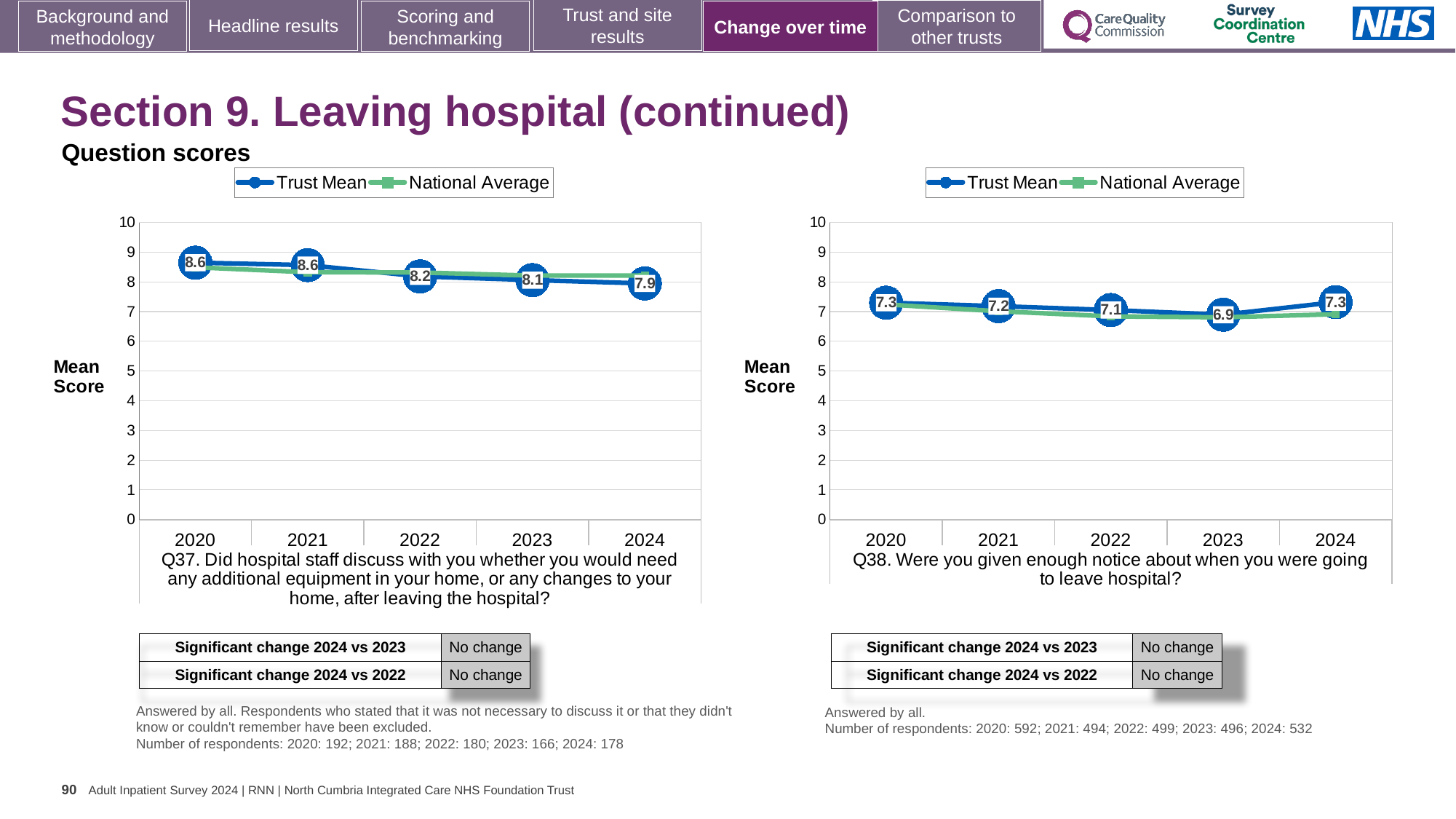
On the Q37 chart (left), what is the difference between the Trust Mean score in 2020 and in 2024? 0.7 How many series does the legend of the Q37 chart (left) list? 2 On the Q38 chart (right), what is the difference between the Trust Mean score in 2024 and in 2023? 0.4 On the Q37 chart (left), does the Trust Mean score rise or fall from 2020 to 2024? fall On the Q37 chart (left), what is the Trust Mean score for 2024? 7.9 On the Q38 chart (right), which year has the lowest Trust Mean score? 2023 On the Q38 chart (right), what is the Trust Mean score for 2024? 7.3 On the Q38 chart (right), what is the Trust Mean score for 2023? 6.9 How many years are plotted on the Q38 chart (right)? 5 On the Q37 chart (left), what is the Trust Mean score for 2020? 8.6 On the Q37 chart (left), is the Trust Mean score for 2022 greater or less than 8? greater On the Q37 chart (left), which year has the lowest Trust Mean score? 2024